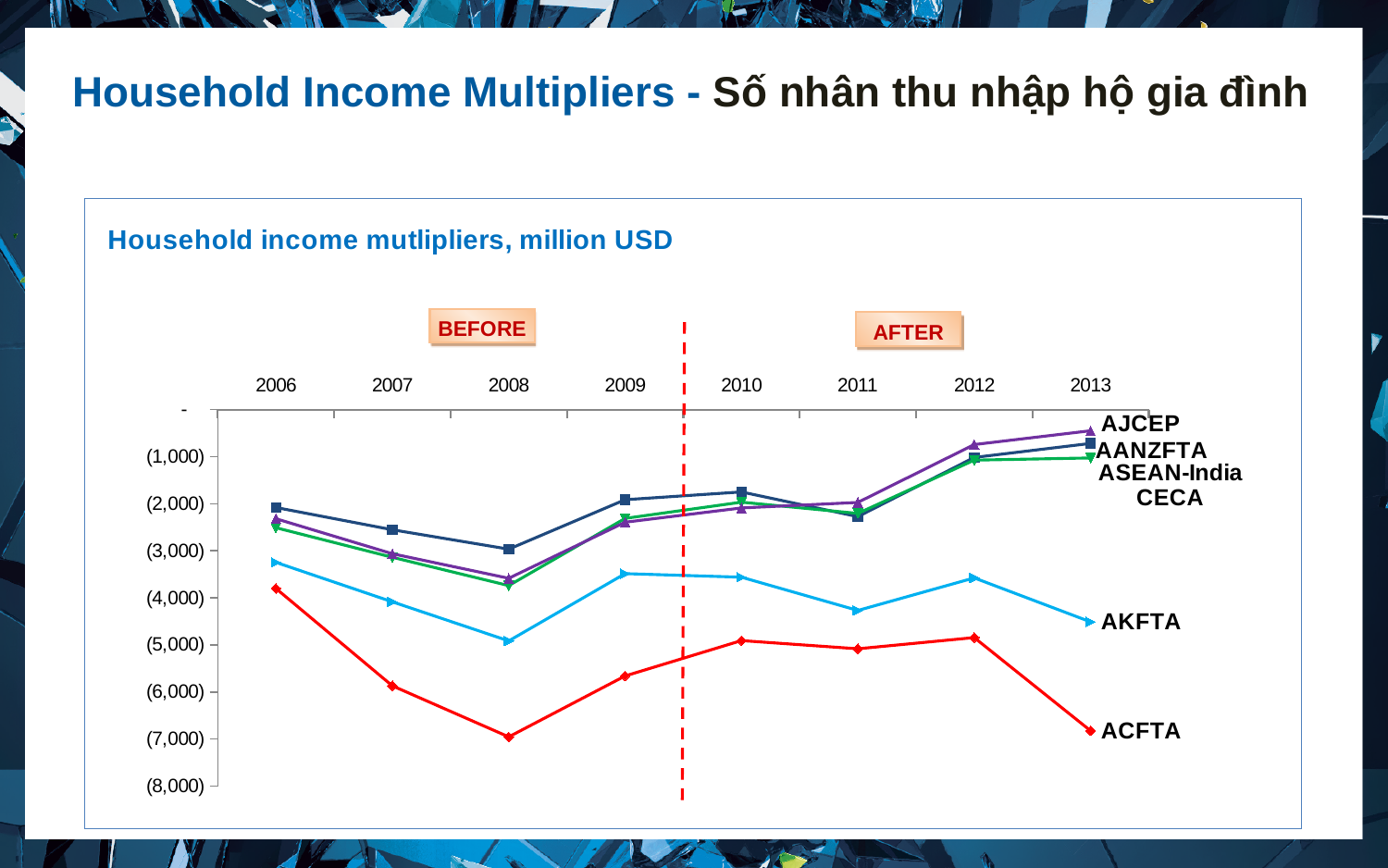
Which series has the lowest values across all years in the chart? ACFTA In which year is the AKFTA series at its lowest value? 2008 Does the ACFTA series rise or fall from 2006 to 2008? fall How many series (FTAs) are plotted in the chart? 5 How many years are plotted along the x axis of the chart? 8 Which is larger in 2013, the value for AKFTA or the value for ACFTA? AKFTA In which year is the AANZFTA series at its highest value? 2013 What kind of chart is shown on the slide? line chart Is the value for AKFTA in 2006 greater or less than (4,000)? greater Is the value for AANZFTA in 2013 greater or less than (1,000)? greater What is the title of the chart? Household income mutlipliers, million USD Is the value for ACFTA in 2008 greater or less than (6,000)? less